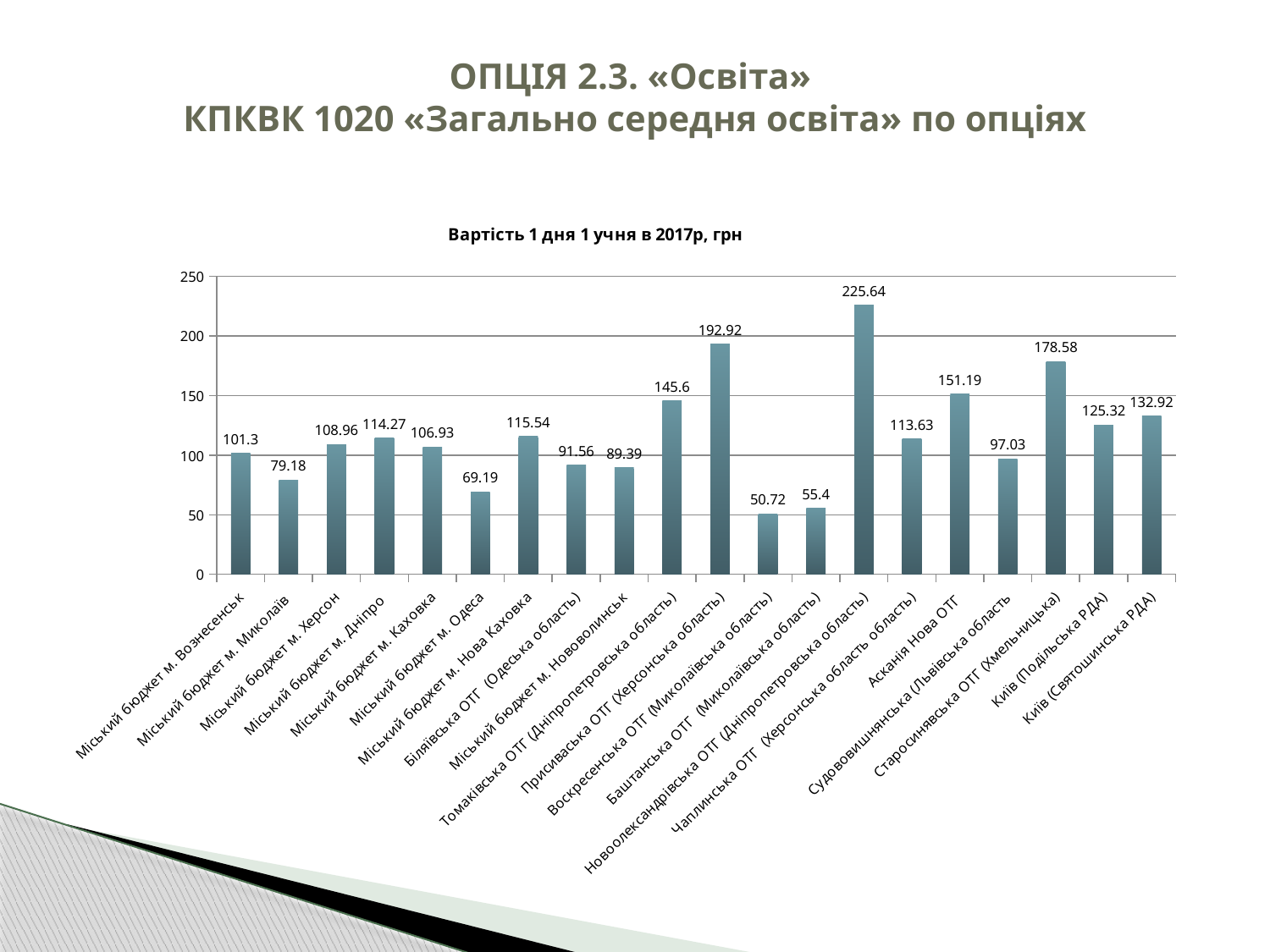
What kind of chart is shown on the slide? bar chart Which category has the highest value? Новоолександрівська ОТГ (Дніпропетровська область) Is the value for Старосинявська ОТГ (Хмельницька) greater or less than 150? greater How many categories are shown on the x axis? 20 Which is larger, the value for Міський бюджет м. Херсон or the value for Міський бюджет м. Дніпро? Міський бюджет м. Дніпро What is the difference between the values for Київ (Святошинська РДА) and Київ (Подільська РДА)? 7.6 What is the value for Асканія Нова ОТГ? 151.19 Which category has the lowest value? Воскресенська ОТГ (Миколаївська область) What is the difference between the values for Присиваська ОТГ (Херсонська область) and Томаківська ОТГ (Дніпропетровська область)? 47.32 What is the value for Міський бюджет м. Одеса? 69.19 What is the title of the chart? Вартість 1 дня 1 учня в 2017р, грн What is the value for Київ (Святошинська РДА)? 132.92